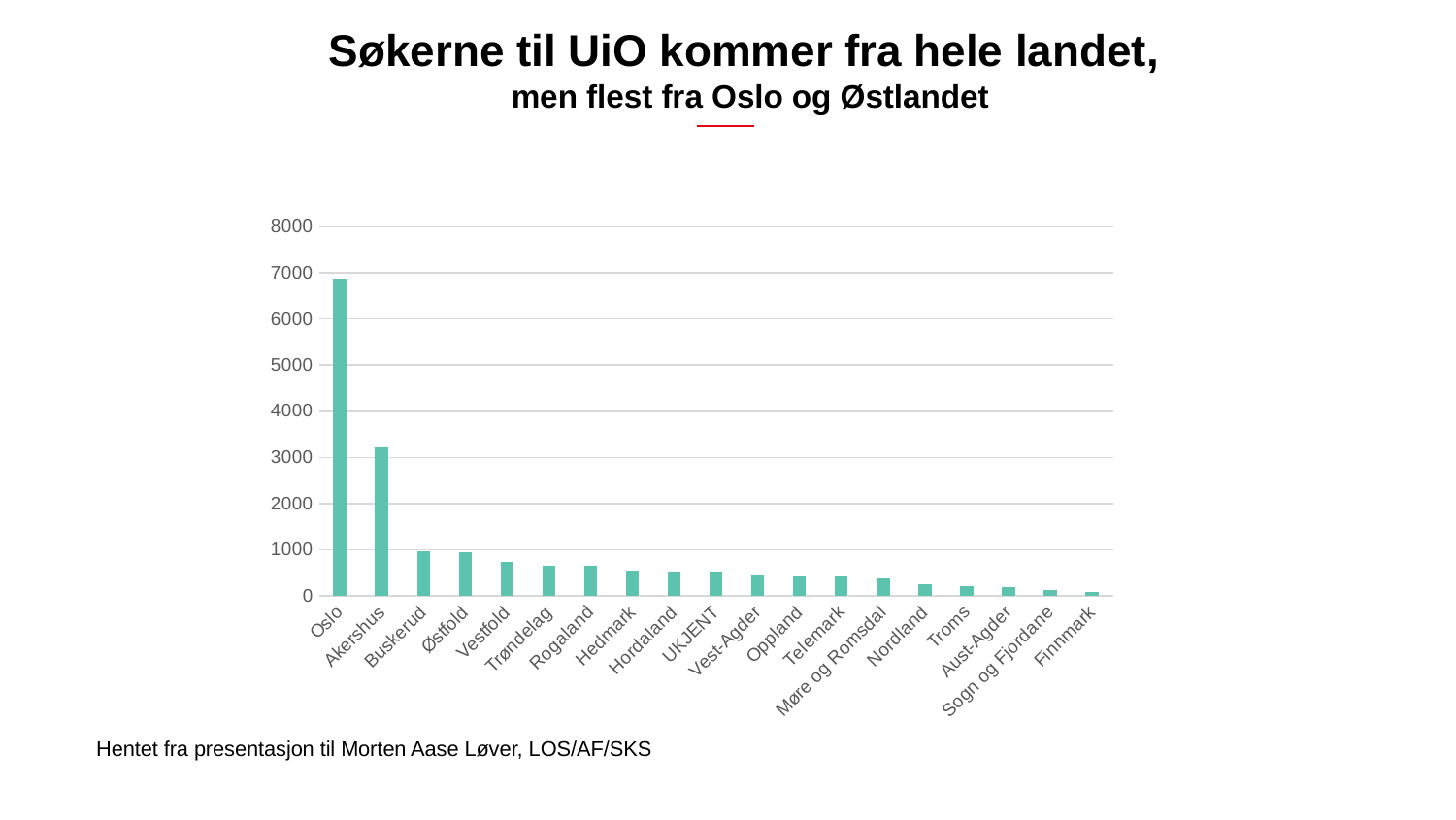
Is the value for Vestfold greater or less than 1000? less Which category has the highest value in the chart? Oslo Which is larger, the value for Nordland or the value for Vestfold? Vestfold Is the value for Akershus greater or less than 3000? greater What kind of chart is shown on the slide? bar chart Is the value for Buskerud greater or less than 2000? less Which is larger, the value for Akershus or the value for Østfold? Akershus What is the main title of the slide above the chart? Søkerne til UiO kommer fra hele landet, How many categories are shown along the x axis of the chart? 19 Do the values generally rise or fall from left to right along the x axis? fall Which category has the lowest value in the chart? Finnmark